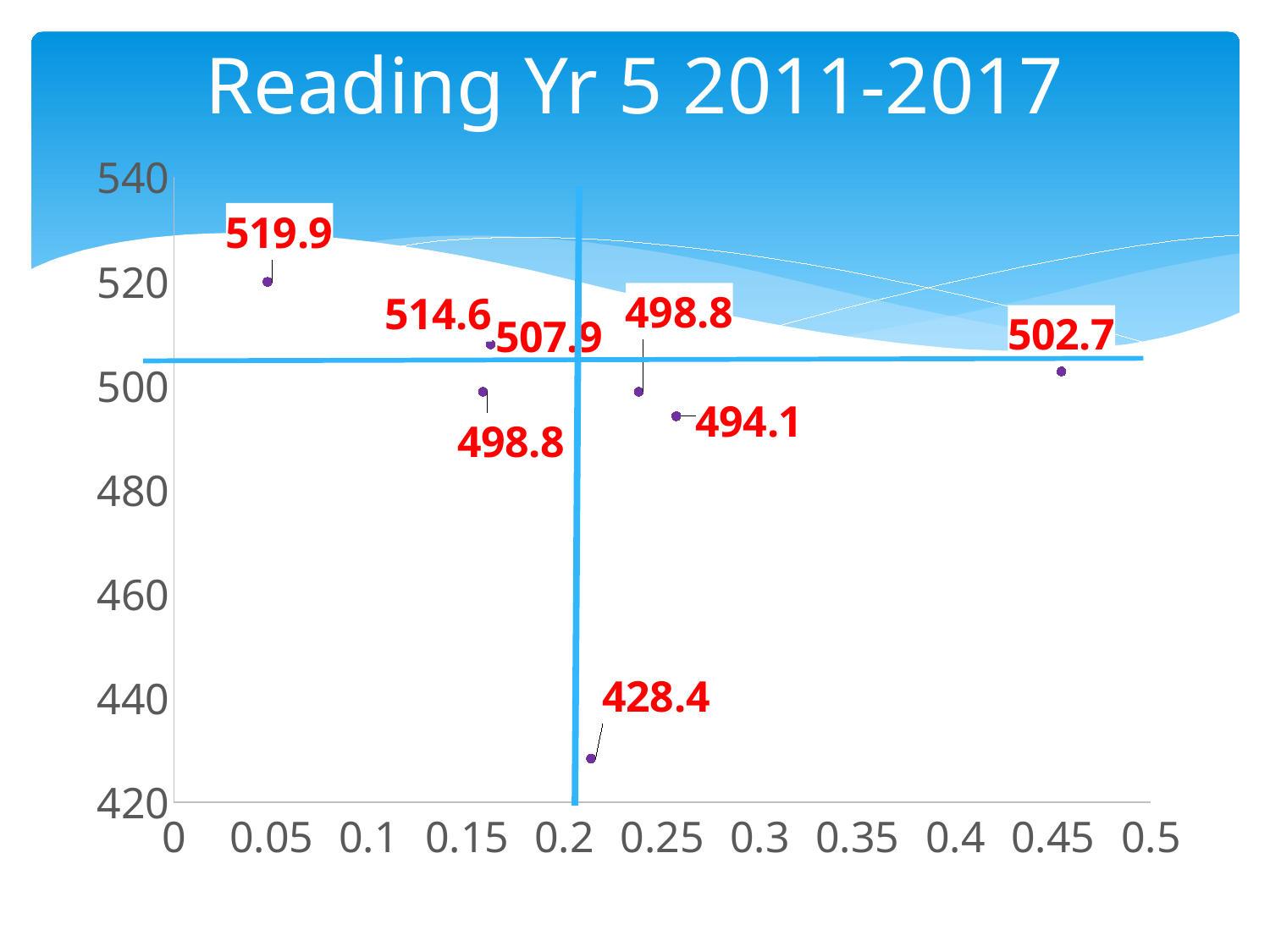
What is the highest data value labelled on the chart? 519.9 Is the value of the lowest data point greater or less than 440? less What is the difference between the values labelled 514.6 and 507.9? 6.7 What is the value of the data point plotted at about 0.05 on the x axis? 519.9 What is the difference between the highest labelled value (519.9) and the lowest labelled value (428.4)? 91.5 What is the maximum value shown on the y axis? 540 What is the title of the chart? Reading Yr 5 2011-2017 What is the lowest data value labelled on the chart? 428.4 What is the value of the data point plotted at about 0.45 on the x axis? 502.7 What is the difference between the values labelled 502.7 and 494.1? 8.6 What kind of chart is shown on the slide? scatter chart Which is larger, the value labelled 519.9 or the value labelled 502.7? 519.9